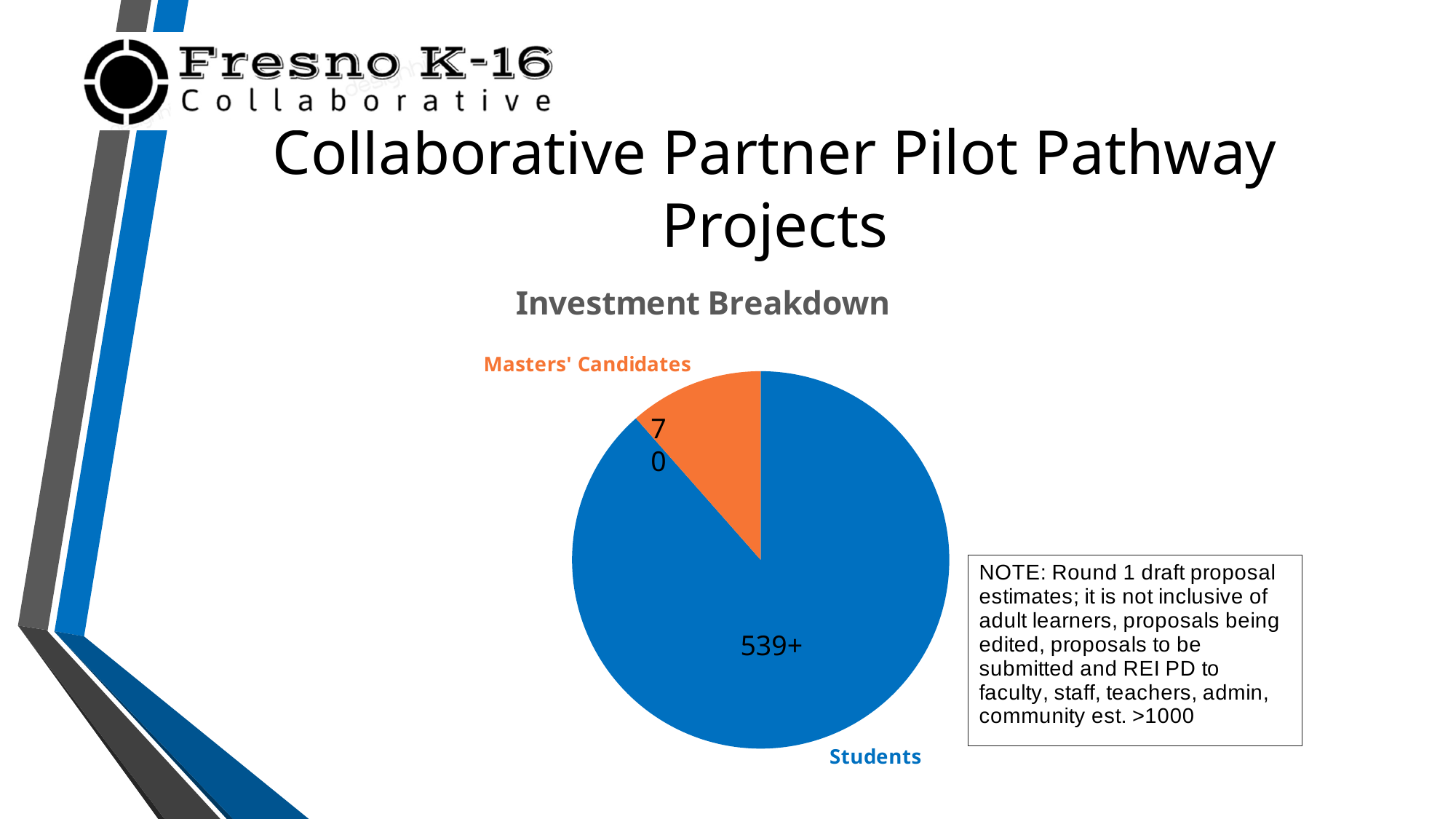
Which category has the smallest slice of the pie? Masters' Candidates How many slices does the pie chart have? 2 What colour is the Masters' Candidates slice? orange What is the title of the chart? Investment Breakdown What kind of chart is shown on the slide? pie chart What value is shown for the Students slice? 539+ Which category has the largest slice of the pie? Students Which is larger, the value for Students or the value for Masters' Candidates? Students What value is shown for the Masters' Candidates slice? 70